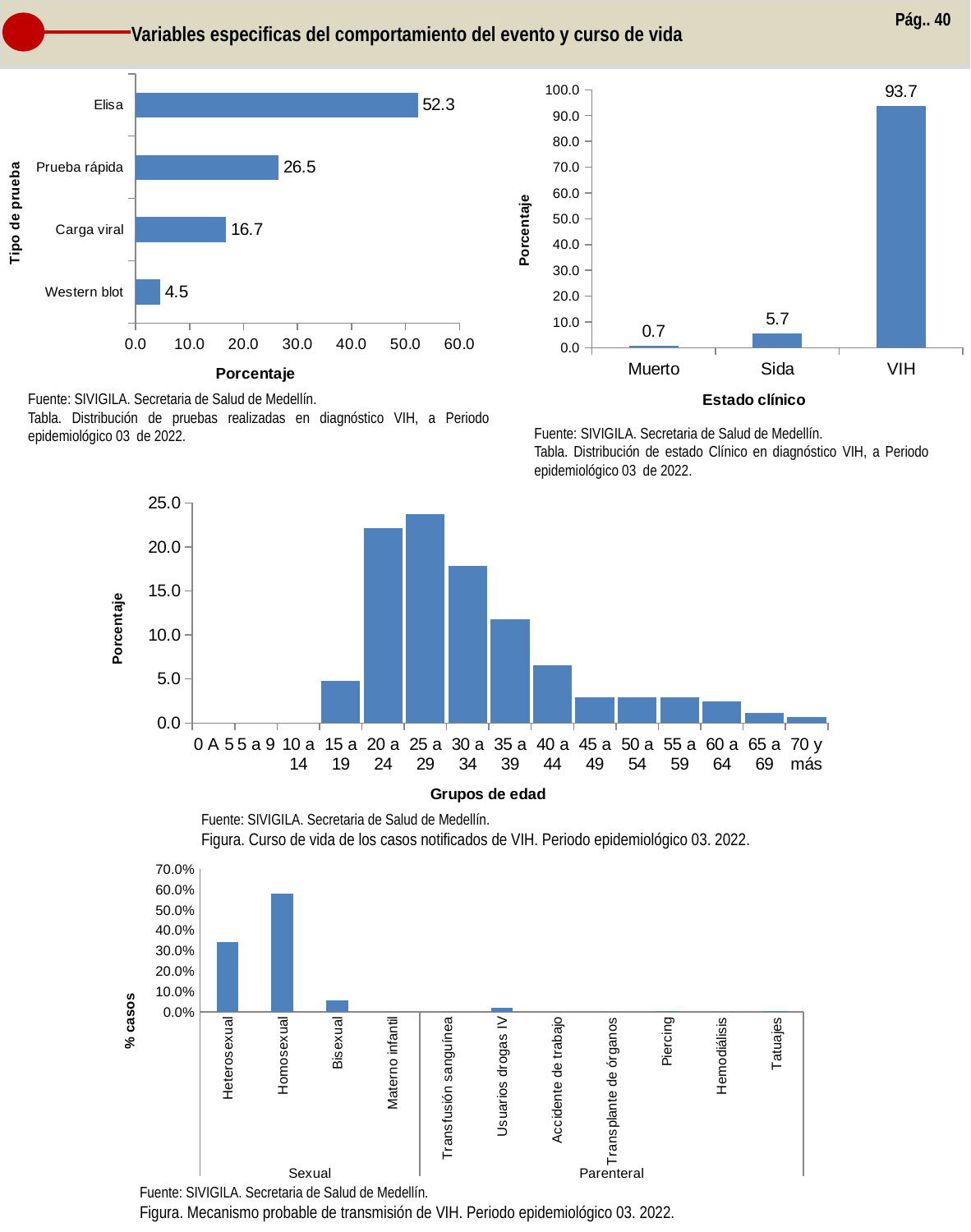
In the top-left chart (Tipo de prueba), what is the value for Elisa? 52.3 In the middle chart (Grupos de edad), which age group has the highest value? 25 a 29 In the top-left chart (Tipo de prueba), which test type has the lowest value? Western blot In the middle chart (Grupos de edad), how many age groups are shown on the x axis? 15 In the top-right chart (Estado clínico), which category has the highest value? VIH In the bottom chart (Mecanismo probable de transmisión), is the value for Bisexual greater or less than 10.0%? less In the top-left chart (Tipo de prueba), how many test types are shown? 4 In the bottom chart (Mecanismo probable de transmisión), which category has the highest value? Homosexual In the top-left chart (Tipo de prueba), what is the difference between Prueba rápida and Carga viral? 9.8 In the middle chart (Grupos de edad), is the value for 35 a 39 greater or less than 10.0? greater In the top-right chart (Estado clínico), what is the difference between VIH and Muerto? 93.0 In the top-right chart (Estado clínico), what is the value for Sida? 5.7